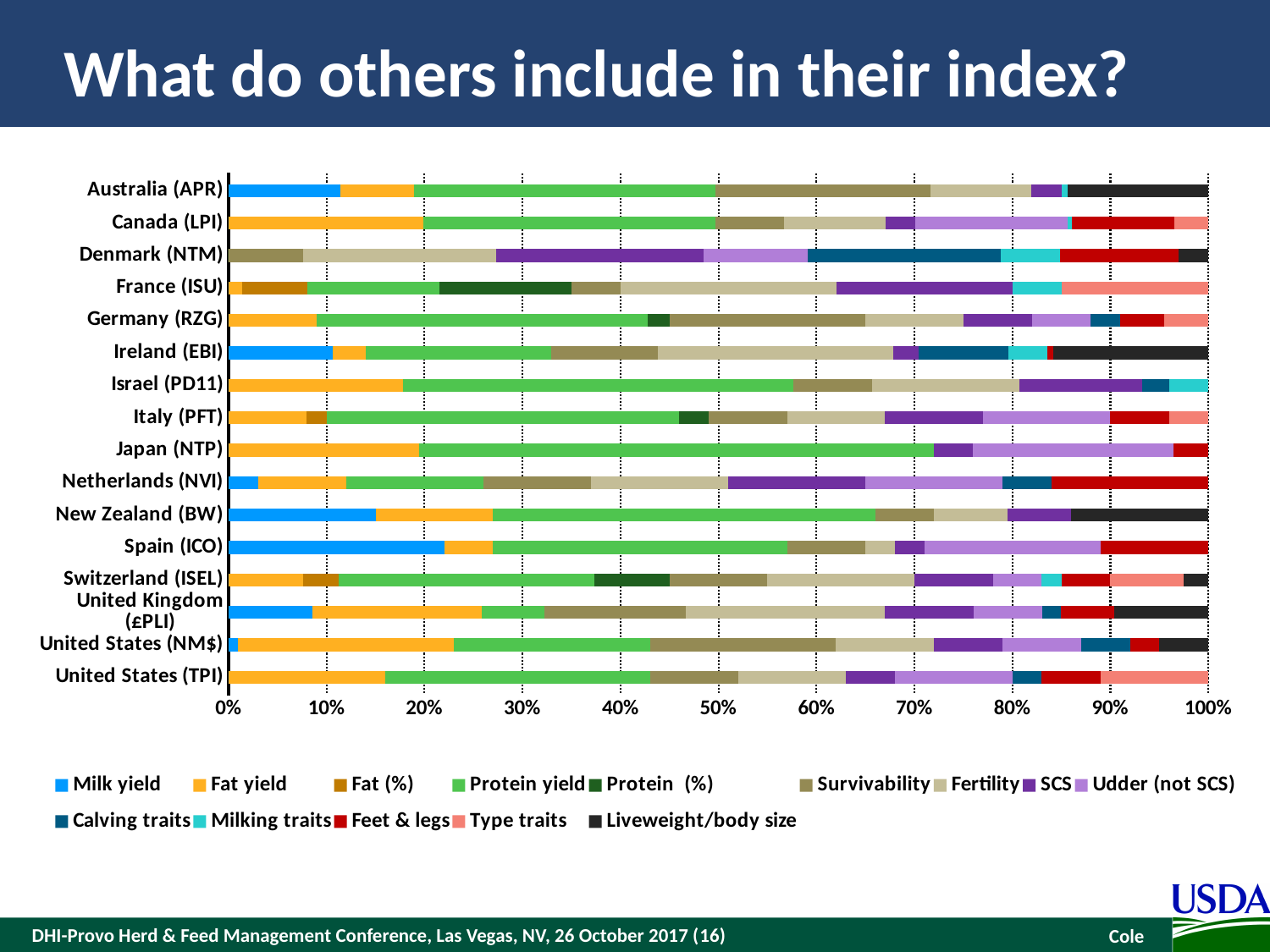
What is the title of the slide containing the chart? What do others include in their index? What is the maximum value shown on the horizontal axis of the chart? 100% Is the Milk yield share for New Zealand (BW) greater or less than 20%? less Which index has the largest Protein yield share in the chart? Japan (NTP) How many country indices (categories) are listed on the vertical axis of the chart? 16 Which index has the largest Calving traits share in the chart? Denmark (NTM) What kind of chart is shown on the slide? bar chart Is the Milk yield share for Australia (APR) greater or less than 10%? greater Which index has the largest Milk yield share, Spain (ICO) or Australia (APR)? Spain (ICO) Is the Milk yield share for Spain (ICO) greater or less than 20%? greater Which index has the largest SCS share in the chart? Denmark (NTM) How many series does the chart legend list? 14